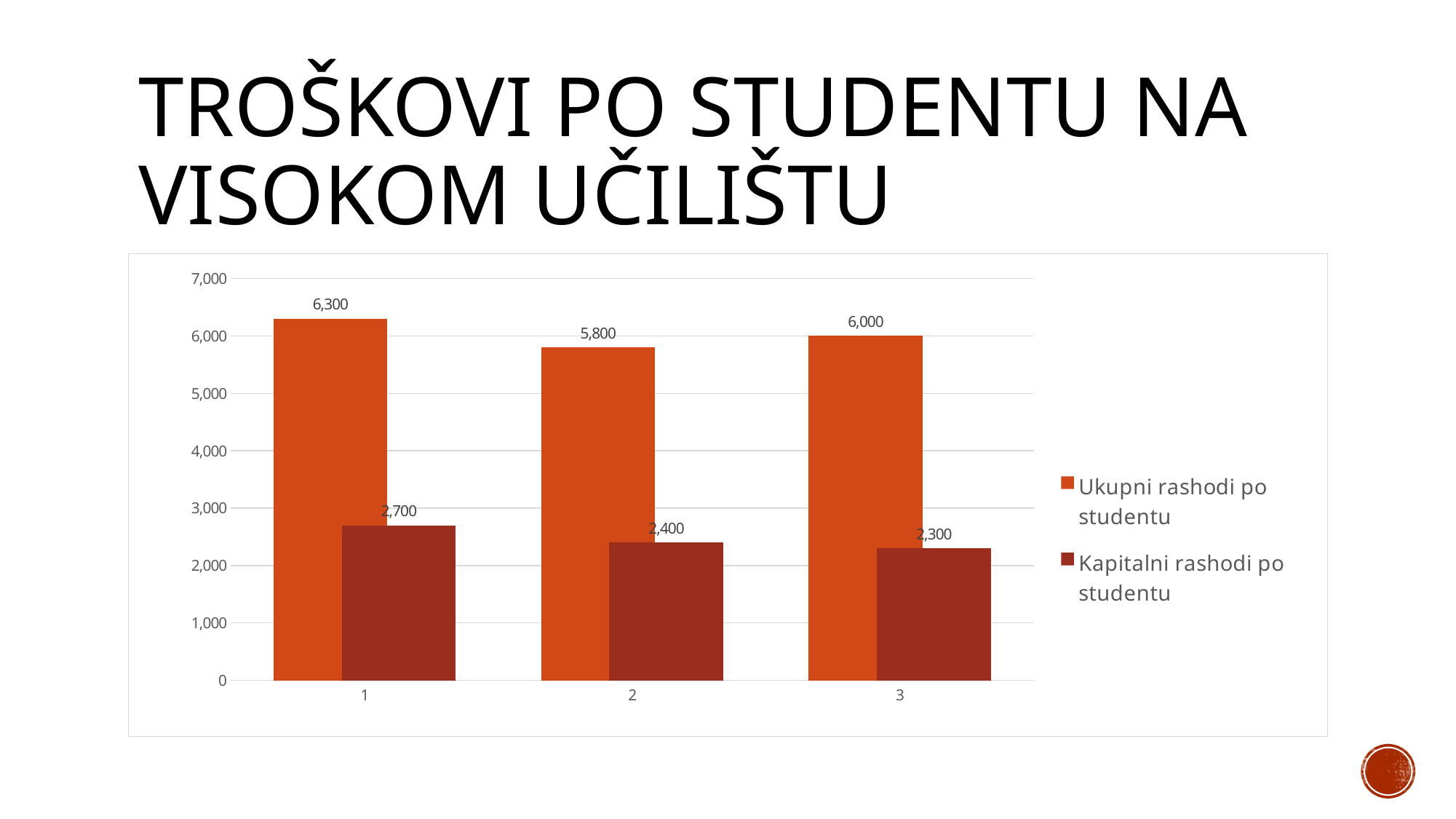
What is the title of the slide? TROŠKOVI PO STUDENTU NA VISOKOM UČILIŠTU Which category has the highest value for Ukupni rashodi po studentu? 1 What is the difference between Ukupni rashodi po studentu and Kapitalni rashodi po studentu for category 2? 3,400 Is the value of Kapitalni rashodi po studentu for category 1 greater or less than 3,000? less What is the value of Ukupni rashodi po studentu for category 1? 6,300 How many series does the legend list? 2 Which is larger: Ukupni rashodi po studentu for category 3 or for category 2? Category 3 What kind of chart is shown on the slide? Bar chart Which category has the lowest value for Kapitalni rashodi po studentu? 3 What is the value of Kapitalni rashodi po studentu for category 3? 2,300 How many categories are shown on the x axis? 3 What is the value of Ukupni rashodi po studentu for category 2? 5,800